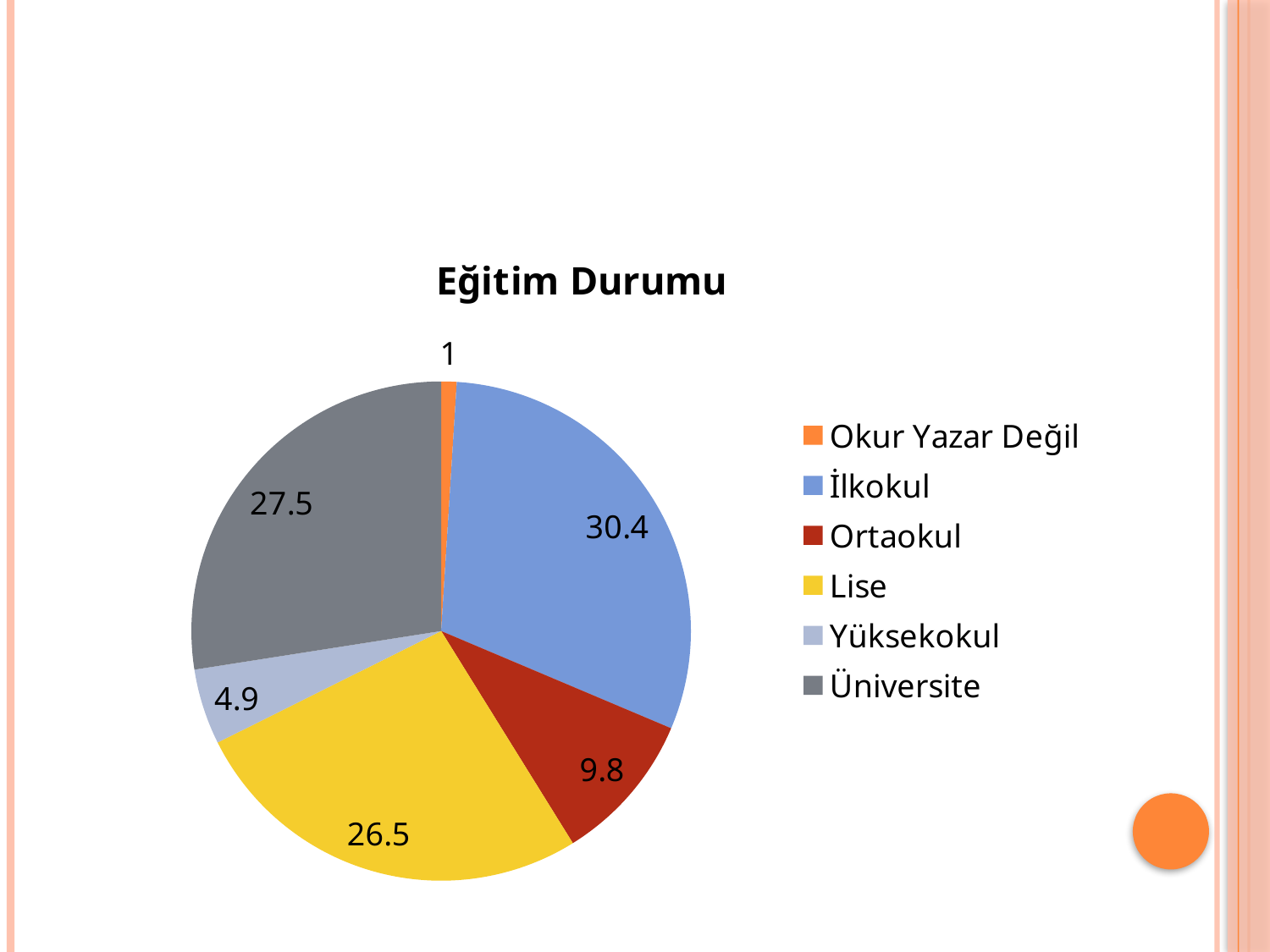
What kind of chart is shown on the slide? Pie chart Which category has the smallest slice in the Eğitim Durumu pie chart? Okur Yazar Değil What is the value for Okur Yazar Değil in the Eğitim Durumu pie chart? 1 What colour is the Lise slice in the Eğitim Durumu pie chart? Yellow Which is larger in the Eğitim Durumu pie chart, Üniversite or Lise? Üniversite How many categories does the Eğitim Durumu pie chart show? 6 What is the difference between the values for Lise and Ortaokul in the Eğitim Durumu pie chart? 16.7 What is the value for İlkokul in the Eğitim Durumu pie chart? 30.4 Which category has the largest slice in the Eğitim Durumu pie chart? İlkokul What is the value for Yüksekokul in the Eğitim Durumu pie chart? 4.9 What is the title of the chart on the slide? Eğitim Durumu What is the value for Üniversite in the Eğitim Durumu pie chart? 27.5